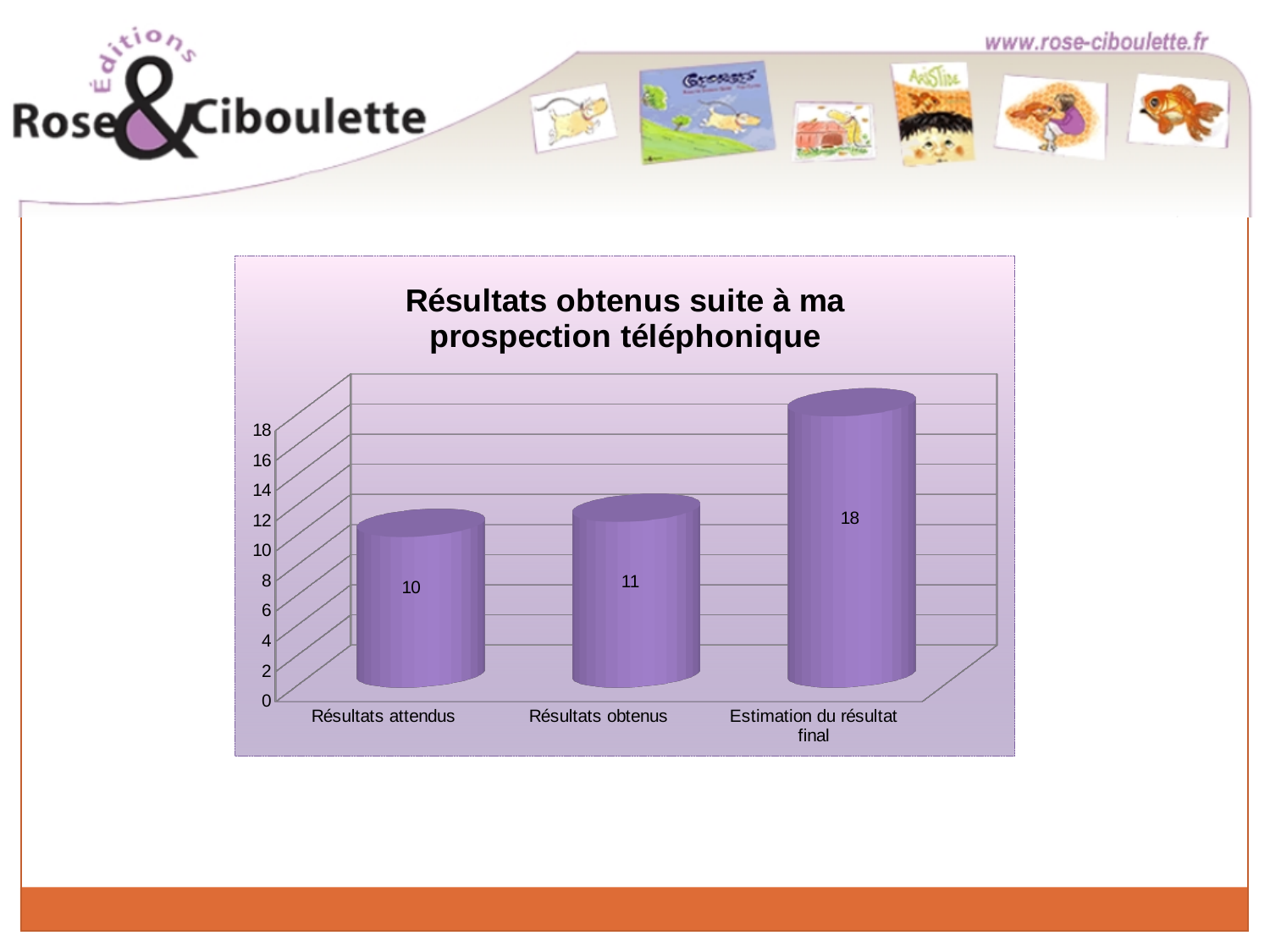
What is the value for Estimation du résultat final? 18 What is the value for Résultats attendus? 10 Do the values rise or fall from left to right along the x axis? Rise What is the difference between Estimation du résultat final and Résultats obtenus? 7 What kind of chart is this? Bar chart What is the title of the chart? Résultats obtenus suite à ma prospection téléphonique What is the value for Résultats obtenus? 11 Which category has the lowest value? Résultats attendus Which category has the highest value? Estimation du résultat final Which is larger, Résultats attendus or Estimation du résultat final? Estimation du résultat final How many categories are shown on the chart? 3 What is the difference between Résultats obtenus and Résultats attendus? 1